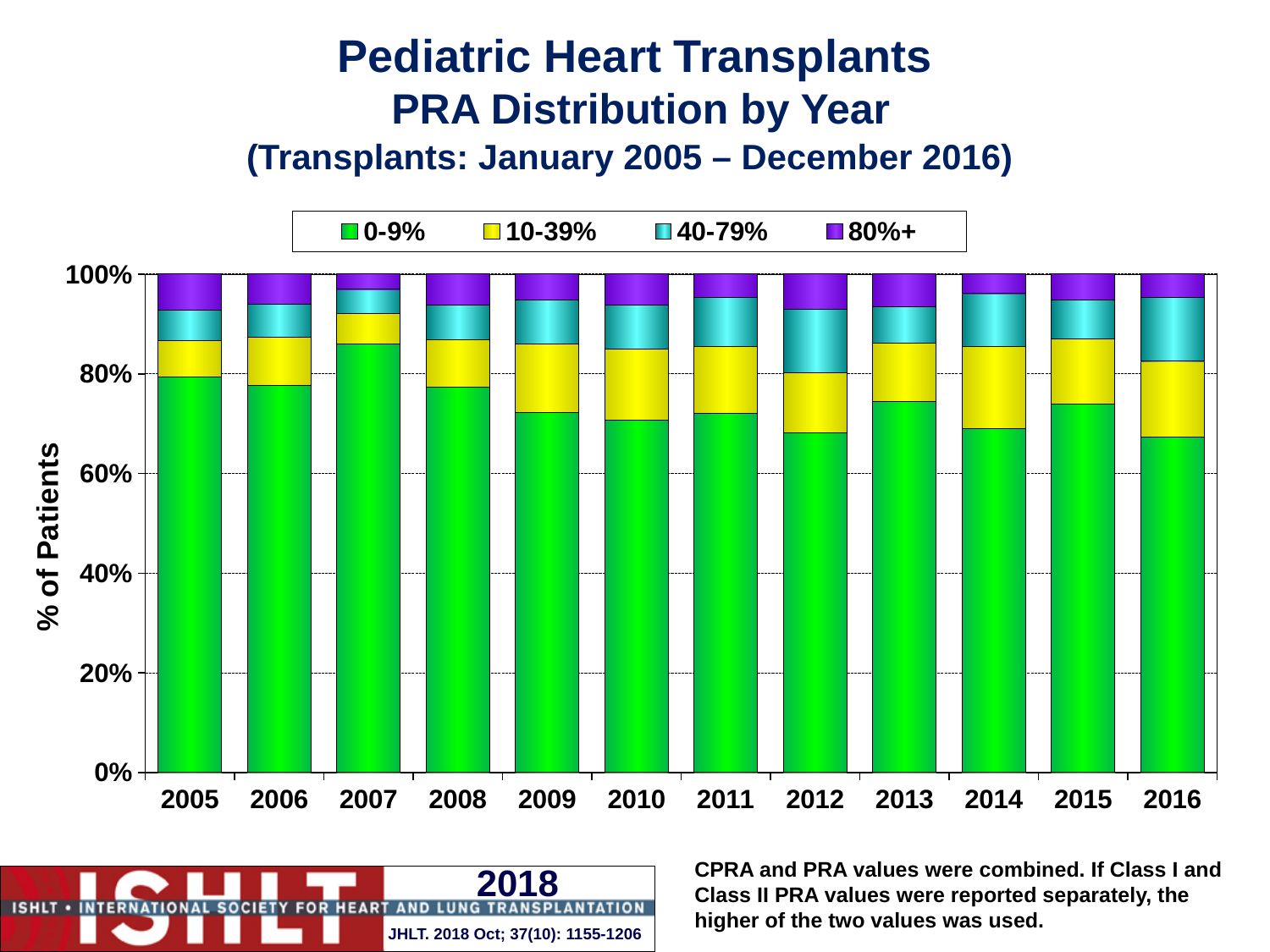
What kind of chart is shown on the slide? Stacked bar chart Is the 0-9% PRA share for 2009 greater or less than 80%? less Which year has the larger 0-9% PRA share, 2007 or 2012? 2007 Which year has the larger 0-9% PRA share, 2008 or 2016? 2008 How many years are shown along the x axis of the chart? 12 Is the 0-9% PRA share for 2007 greater or less than 80%? greater Which year has the largest 0-9% PRA segment? 2007 What does each stacked bar total? 100% How many series does the legend list? 4 Is the 0-9% PRA share for 2012 greater or less than 80%? less What is the label on the y axis of the chart? % of Patients